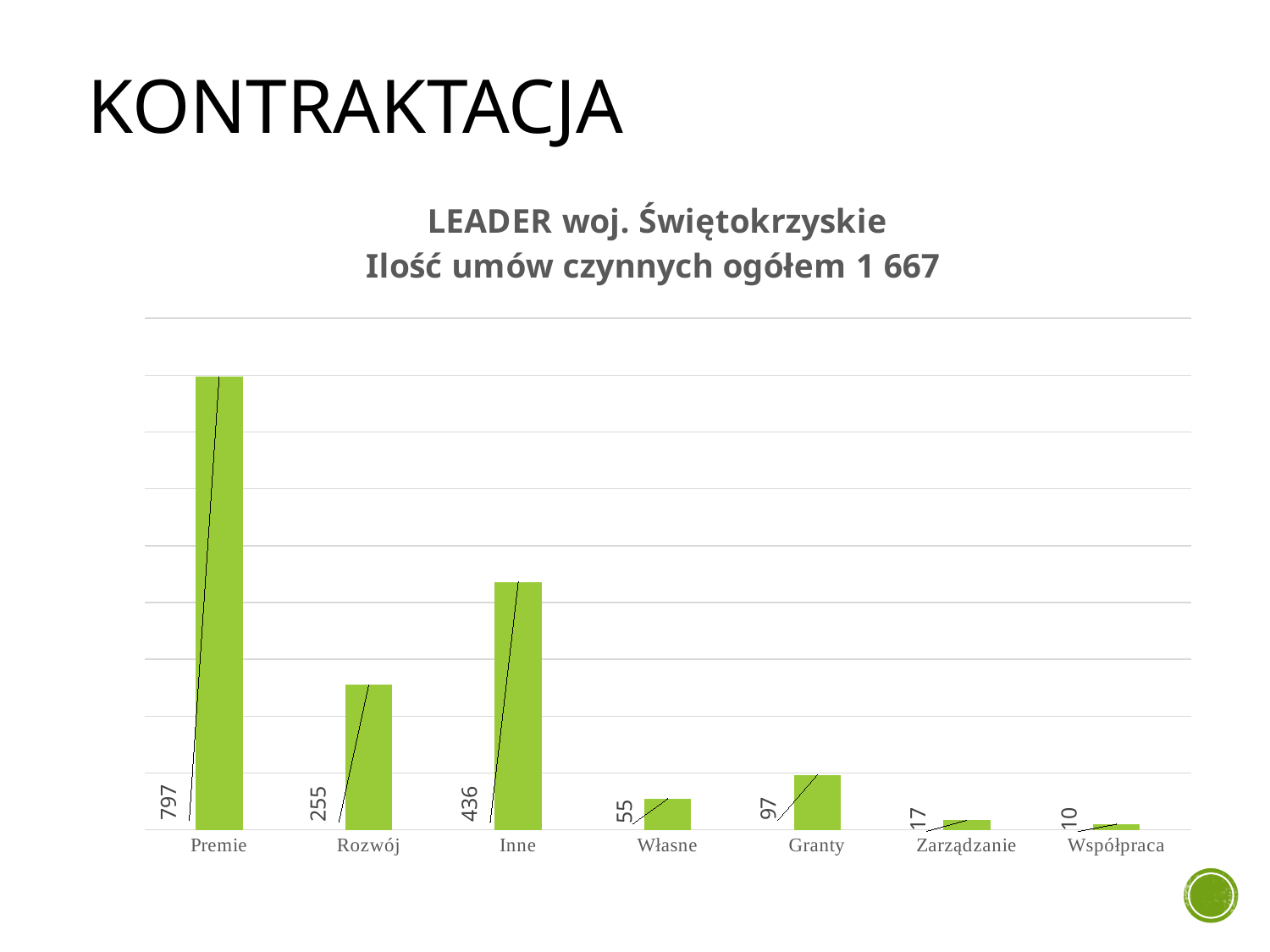
Which category has the lowest value? Współpraca What is the value for Granty? 97 What is the value for Premie? 797 What is the difference between the values for Rozwój and Własne? 200 What is the difference between the values for Premie and Inne? 361 What is the value for Zarządzanie? 17 How many categories are shown on the x axis? 7 What kind of chart is shown on the slide? Bar chart What is the value for Inne? 436 Which category has the highest value? Premie Which is larger, the value for Rozwój or the value for Granty? Rozwój What total number of active contracts is stated in the chart title? 1 667